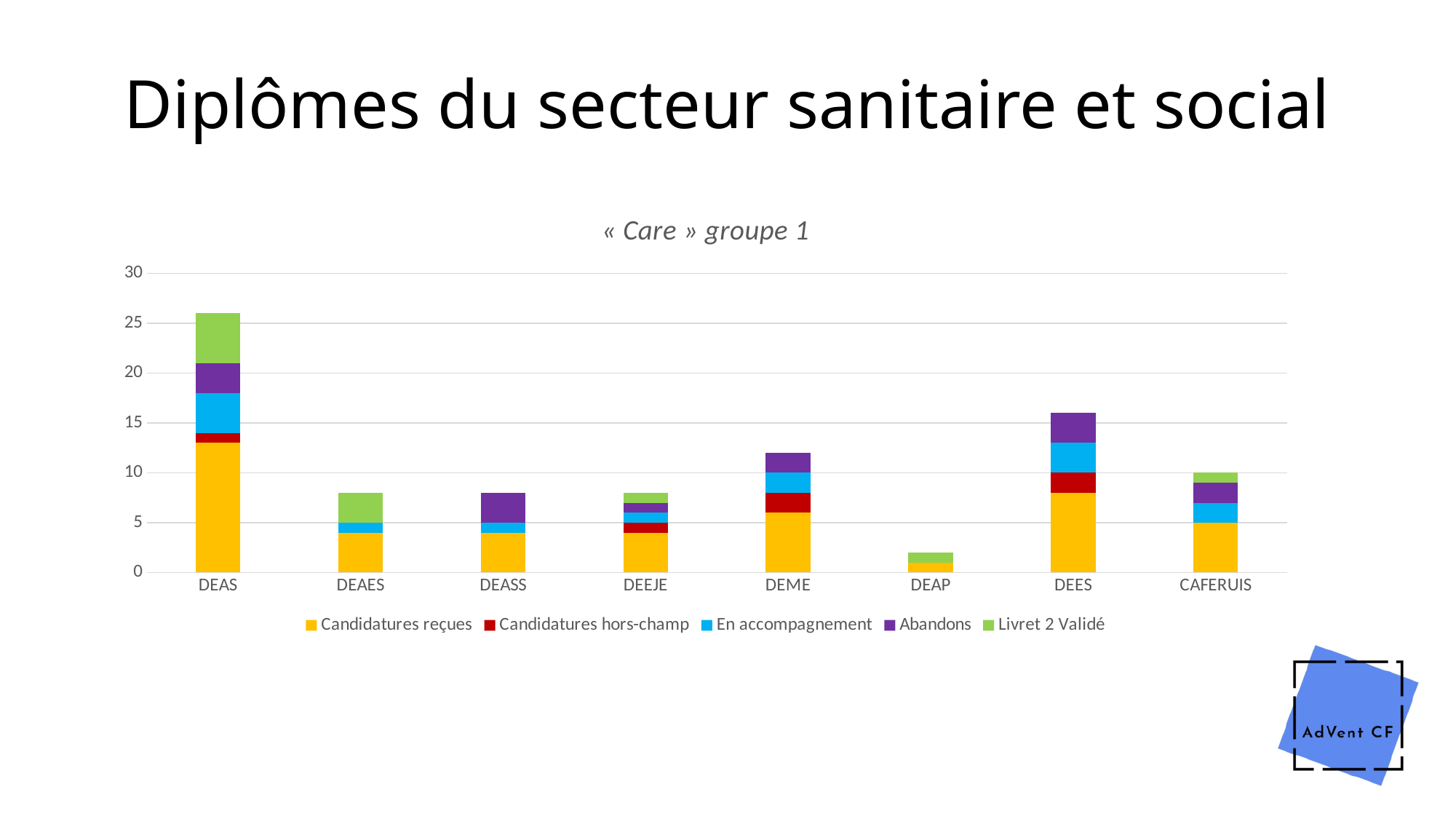
How many series does the legend list? 5 Which series is shown in yellow in the legend? Candidatures reçues What kind of chart is shown on the slide? stacked bar chart Which has the larger total stacked bar, DEES or DEME? DEES Is the total stacked value for DEAP greater or less than 5? less Is the total stacked value for DEAS greater or less than 25? greater What is the title of the chart? « Care » groupe 1 How many categories are shown on the x axis? 8 Is the total stacked value for DEES greater or less than 15? greater Which category has the tallest stacked bar overall? DEAS Which category has the shortest stacked bar overall? DEAP